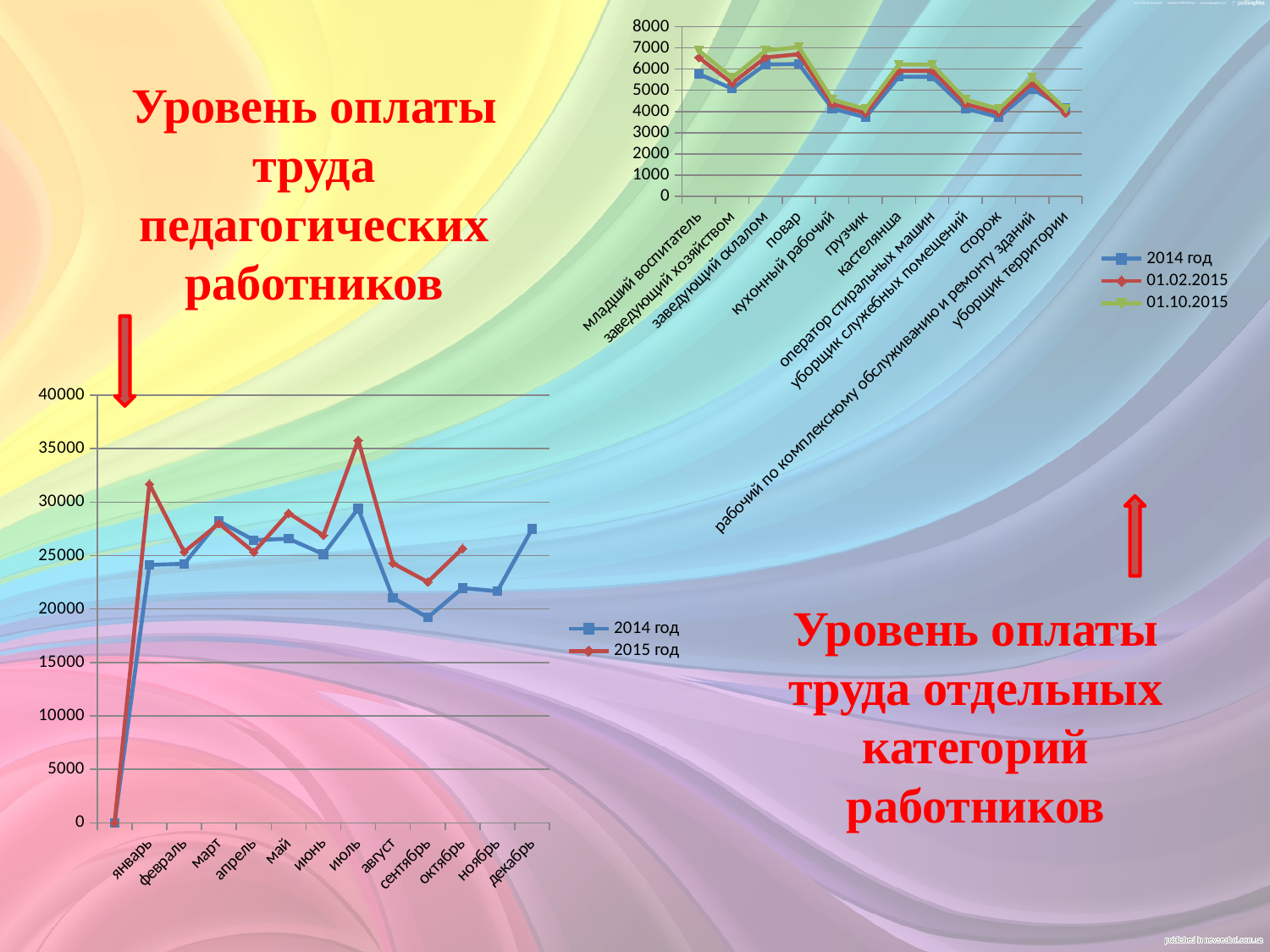
How many months are shown on the x axis of the left chart? 12 In the left chart, is the value for июль in the 2015 год series greater or less than 30000? greater In the left chart (months on the x axis), which month has the highest value for the 2015 год series? июль How many series does the legend of the right chart (job categories on the x axis) list? 3 What kind of chart is the chart on the left of the slide (months on the x axis)? line chart How many series does the legend of the left chart (months on the x axis) list? 2 In the left chart, which series has the larger value for июль: 2014 год or 2015 год? 2015 год How many job categories are shown on the x axis of the right chart? 12 In the right chart, which category has the larger value in the 2014 год series: повар or грузчик? повар In the left chart, is the value for сентябрь in the 2014 год series greater or less than 20000? less In the left chart (months on the x axis), which month has the lowest value for the 2014 год series? сентябрь